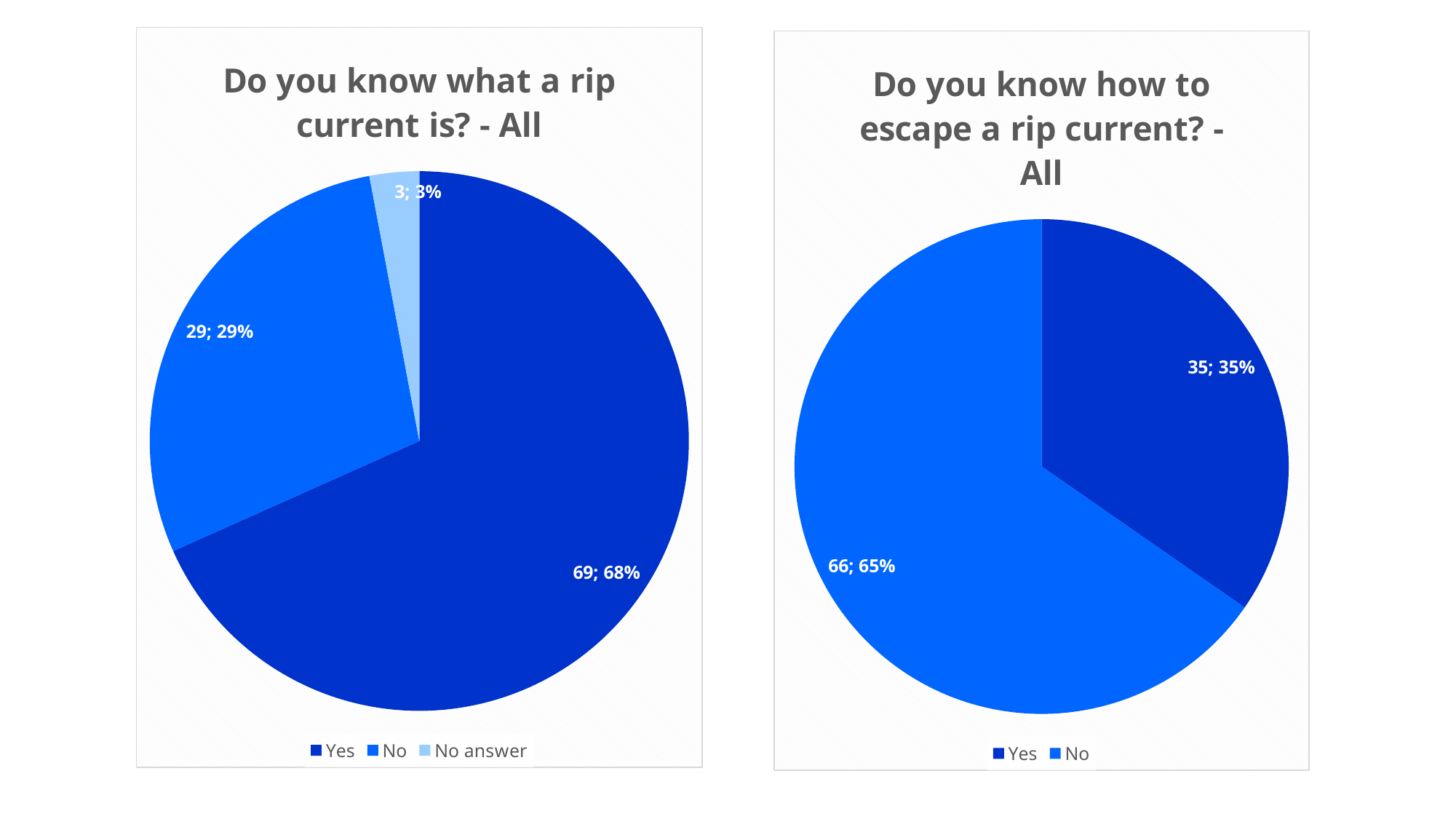
In the chart titled "Do you know what a rip current is? - All", what is the count for No answer? 3 In the chart titled "Do you know how to escape a rip current? - All", which is larger, Yes or No? No What kind of chart is the chart on the right of the slide? Pie chart In the chart titled "Do you know how to escape a rip current? - All", what percentage share does Yes have? 35% In the chart titled "Do you know how to escape a rip current? - All", what is the count for No? 66 In the chart titled "Do you know what a rip current is? - All", what percentage share does No have? 29% In the chart titled "Do you know what a rip current is? - All", what is the count for Yes? 69 In the chart titled "Do you know what a rip current is? - All", how many categories does the legend list? 3 In the chart titled "Do you know what a rip current is? - All", which category has the smallest slice? No answer In the chart titled "Do you know what a rip current is? - All", what is the difference between the counts for Yes and No? 40 In the chart titled "Do you know how to escape a rip current? - All", what is the difference between the counts for No and Yes? 31 In the chart titled "Do you know what a rip current is? - All", which category has the largest slice? Yes